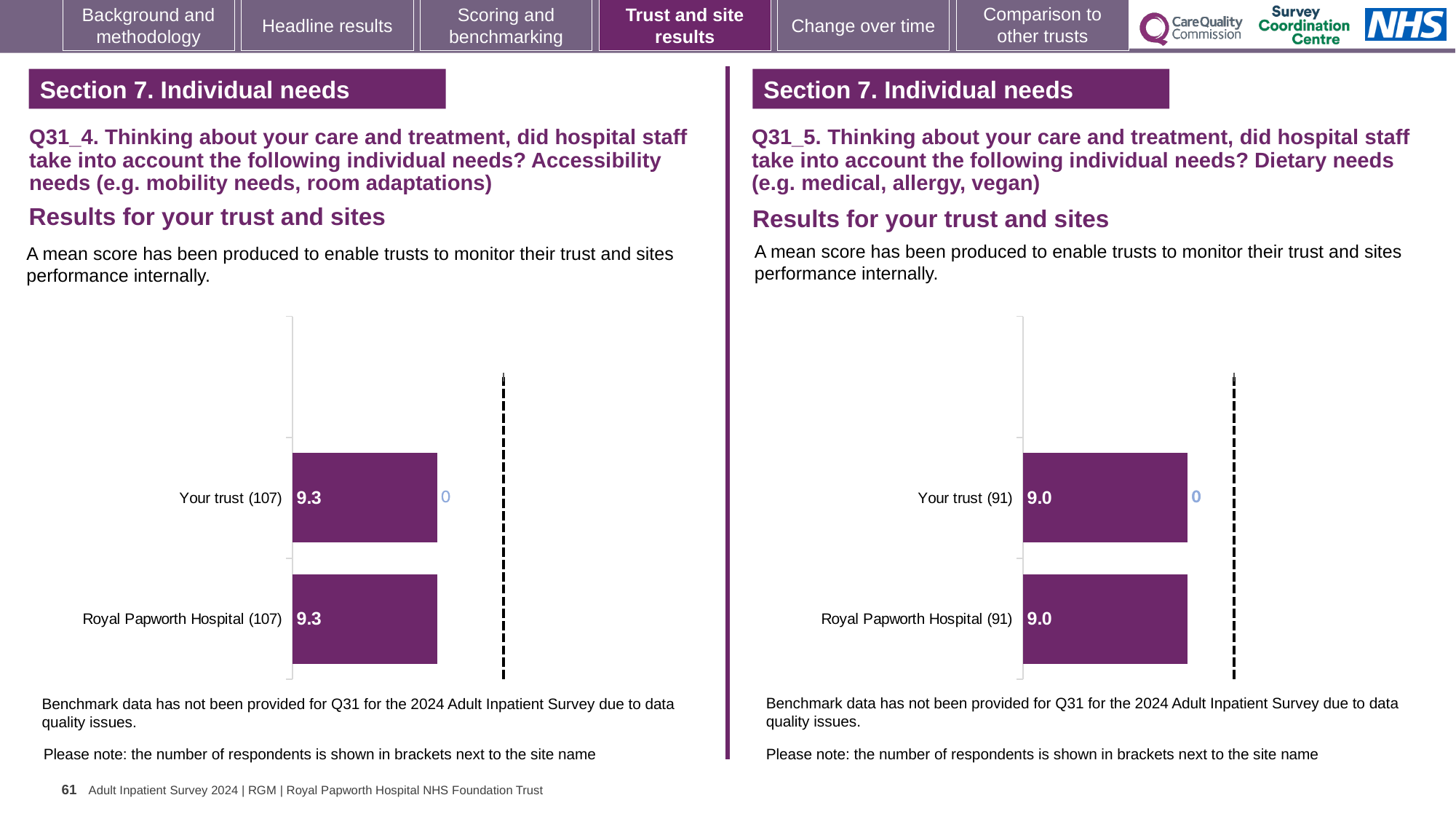
On the left chart (Q31_4, accessibility needs), what is the mean score for Royal Papworth Hospital? 9.3 On the right chart (Q31_5, dietary needs), how many categories are shown? 2 On the left chart (Q31_4, accessibility needs), how many bars are plotted? 2 On the right chart (Q31_5, dietary needs), how many respondents are shown in brackets for Royal Papworth Hospital? 91 On the right chart (Q31_5, dietary needs), what is the mean score for Your trust? 9.0 On the right chart (Q31_5, dietary needs), what is the mean score for Royal Papworth Hospital? 9.0 Is the Your trust score on the left chart (Q31_4) larger or smaller than the Your trust score on the right chart (Q31_5)? Larger On the right chart (Q31_5, dietary needs), what is the difference between the scores for Your trust and Royal Papworth Hospital? 0.0 On the left chart (Q31_4, accessibility needs), what is the difference between the scores for Your trust and Royal Papworth Hospital? 0.0 On the left chart (Q31_4, accessibility needs), what is the mean score for Your trust? 9.3 What kind of chart is used on the left (Q31_4, accessibility needs)? Bar chart On the left chart (Q31_4, accessibility needs), how many respondents are shown in brackets for Your trust? 107